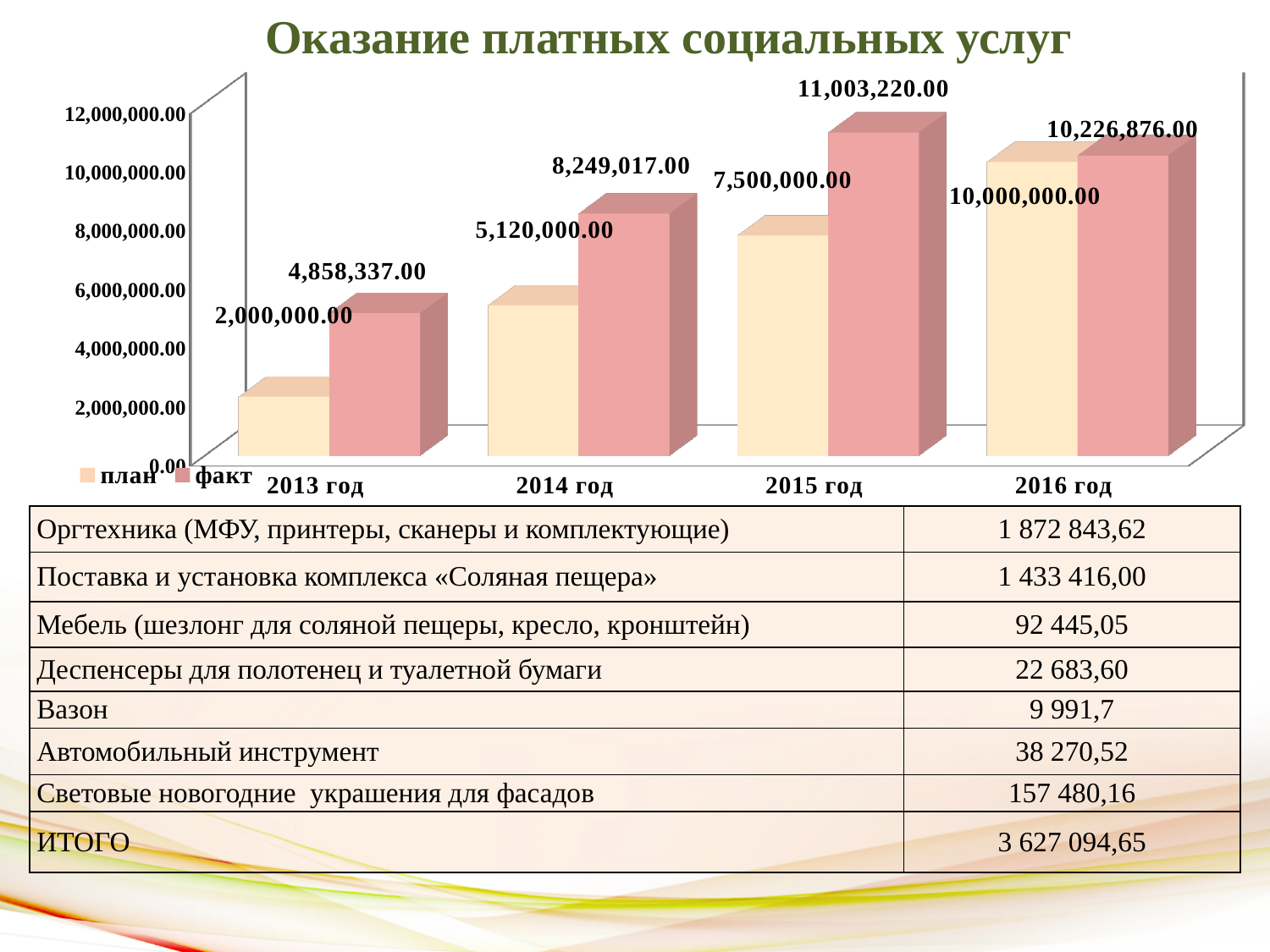
What is the факт value for 2015 год? 11,003,220.00 What is the факт value for 2013 год? 4,858,337.00 What is the difference between the факт and план values for 2016 год? 226,876.00 What is the план value for 2014 год? 5,120,000.00 How many years are shown on the x axis? 4 What is the difference between the факт and план values for 2013 год? 2,858,337.00 What kind of chart is shown on the slide? bar chart For 2016 год, which is larger, план or факт? факт Which year has the lowest план value? 2013 год Do the план values rise or fall from 2013 год to 2016 год? rise Which year has the highest факт value? 2015 год How many series does the legend list? 2